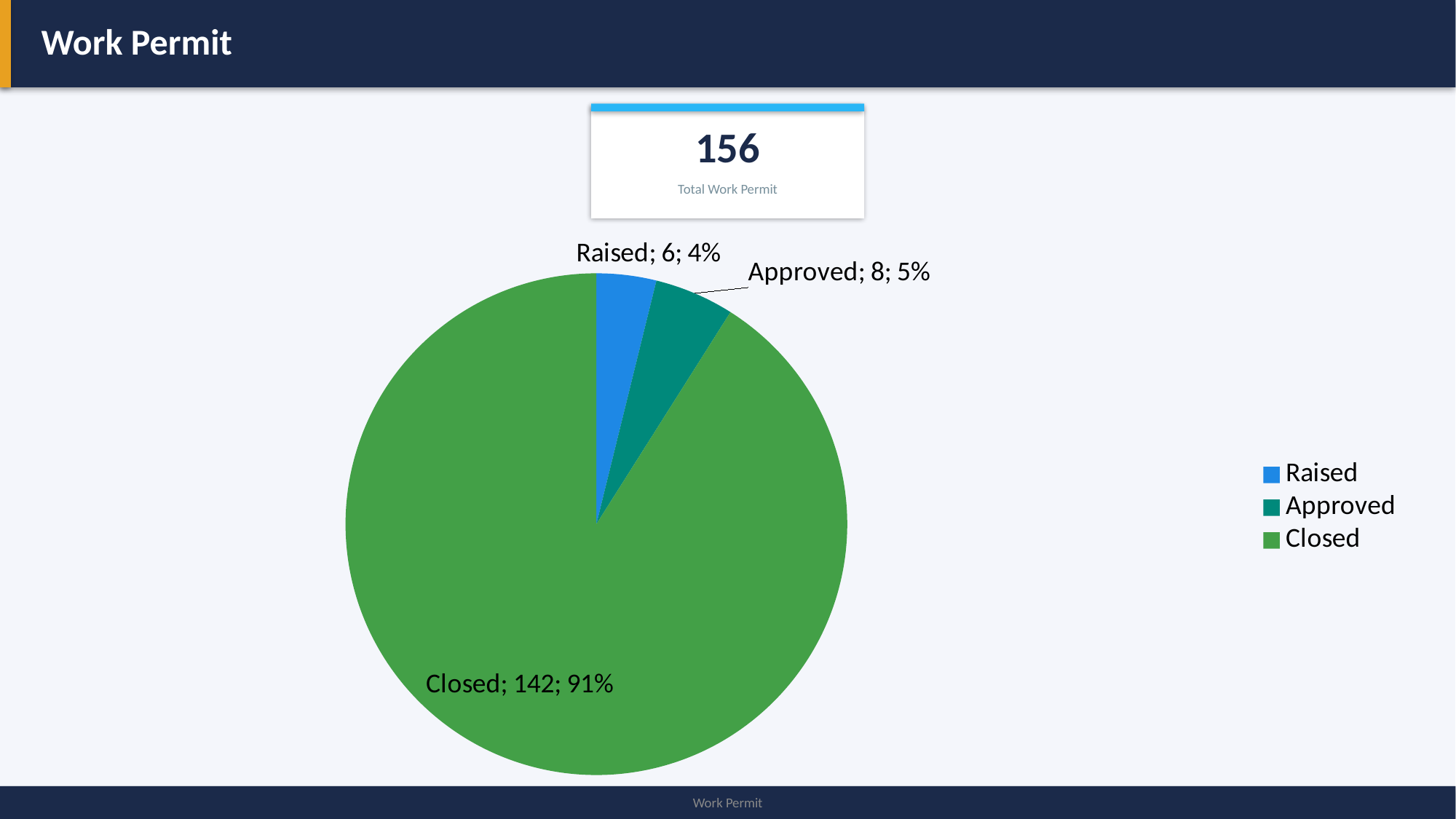
How many work permits are Raised according to the pie chart? 6 What is the total number of work permits shown in the box above the pie chart? 156 How many categories does the pie chart show? 3 How many work permits are Closed according to the pie chart? 142 Which is larger in the pie chart, Approved or Raised? Approved Which category has the largest slice of the pie chart? Closed What is the difference between the Closed and Approved values in the pie chart? 134 What share of the pie does the Closed slice represent? 91% What kind of chart is shown on the slide? pie chart How many work permits are Approved according to the pie chart? 8 What share of the pie does the Approved slice represent? 5% Which category has the smallest slice of the pie chart? Raised